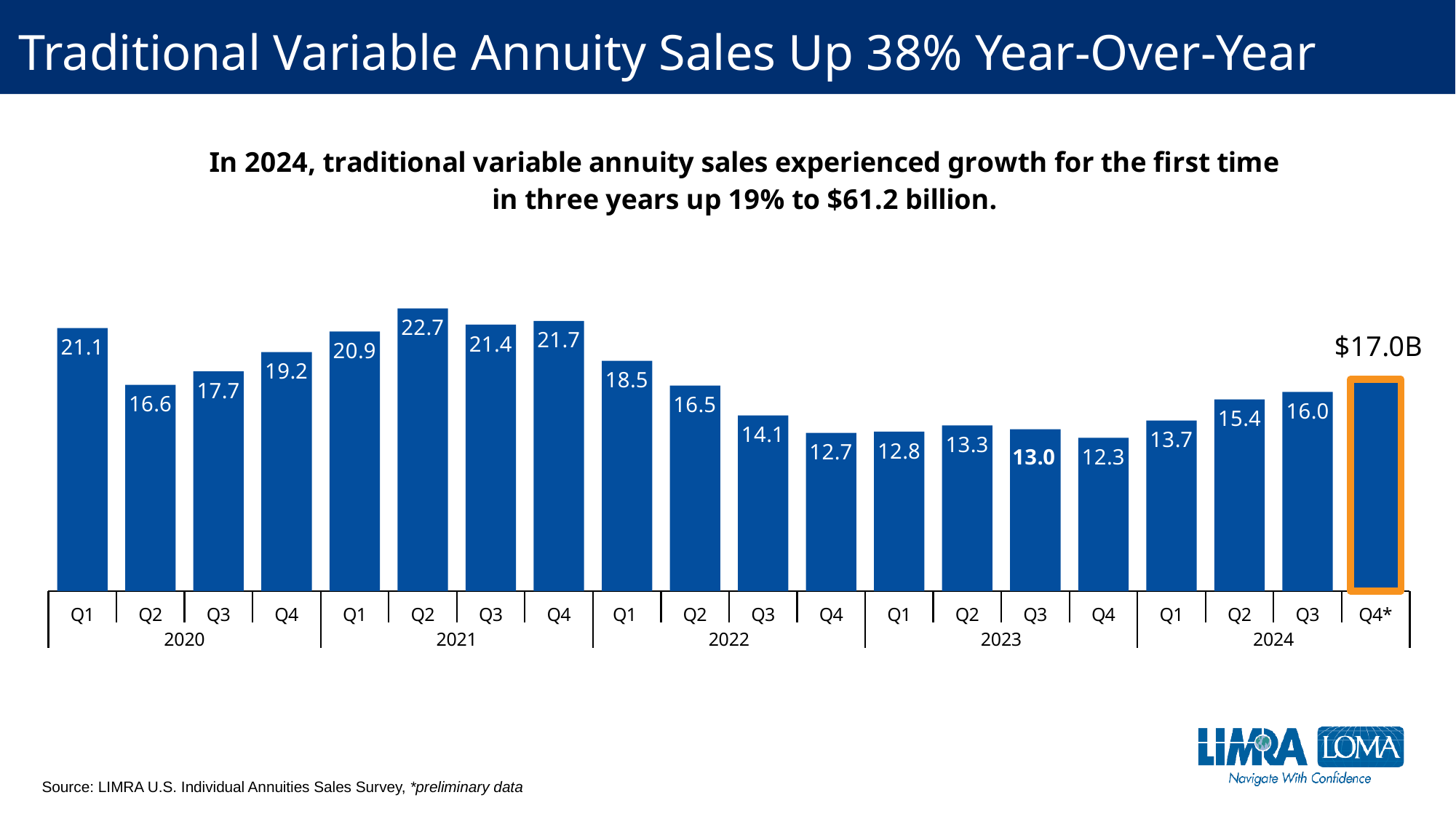
Do the values rise or fall across the four quarters of 2024? Rise Which quarter has the lowest value? Q4 2023 Which bar is highlighted with an orange outline? Q4* 2024 What kind of chart is this? Bar chart Which is larger, Q3 2024 or Q3 2023? Q3 2024 What is the value for Q4* 2024? $17.0B What is the difference between Q1 2020 and Q1 2024? 7.4 What is the value for Q4 2023? 12.3 What is the total of the four quarters of 2023? 51.4 Which quarter has the highest value? Q2 2021 How many bars are shown in the chart? 20 What is the value for Q2 2021? 22.7